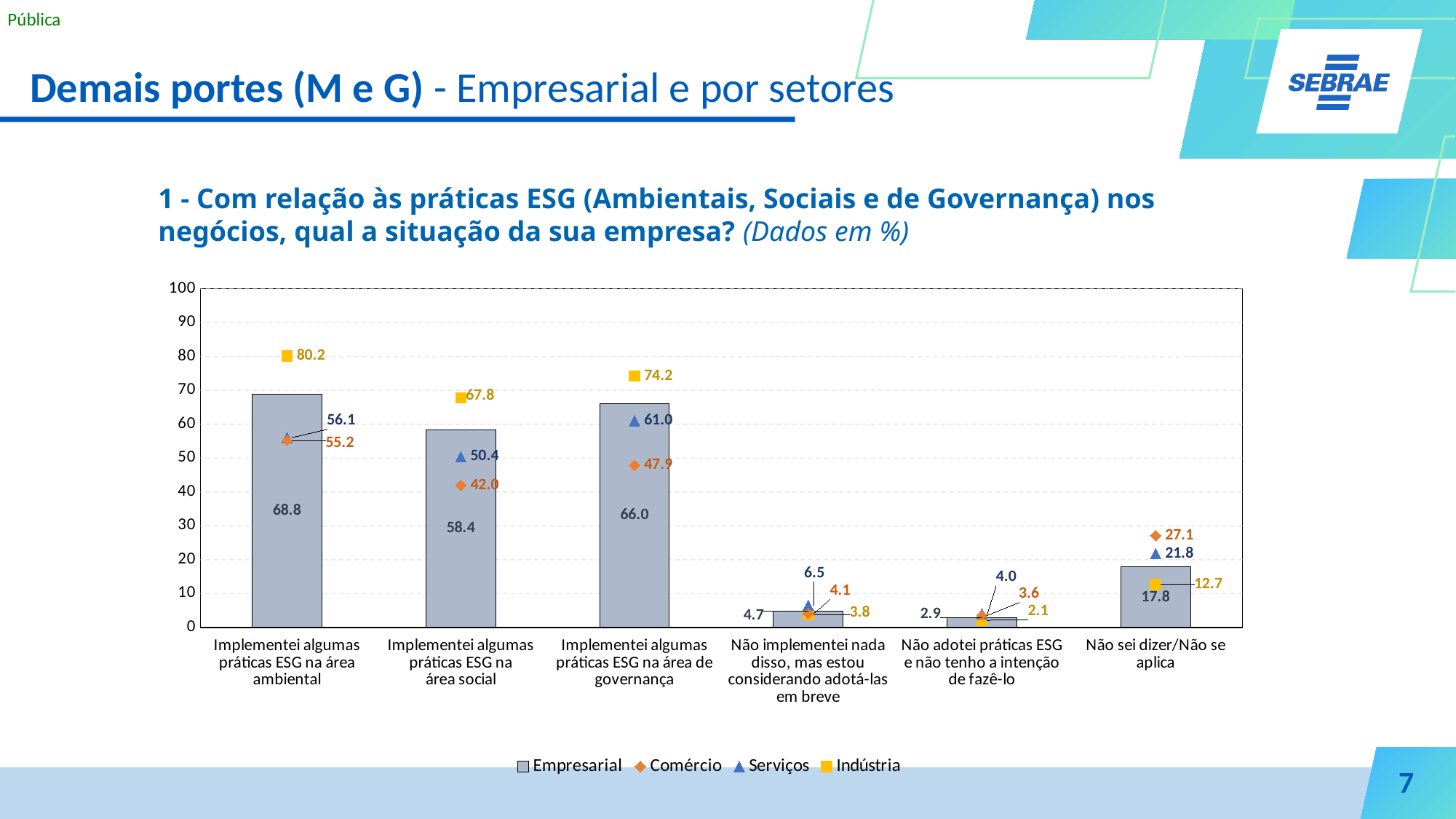
What kind of chart is used for the Empresarial series? Bar chart What is the Serviços value for "Implementei algumas práticas ESG na área social"? 50.4 What is the Indústria value for "Implementei algumas práticas ESG na área de governança"? 74.2 For "Não sei dizer/Não se aplica", which is larger: the Comércio value or the Serviços value? Comércio What is the difference between the Indústria and Empresarial values for "Implementei algumas práticas ESG na área ambiental"? 11.4 How many series does the legend list? 4 Which category has the lowest Empresarial value? Não adotei práticas ESG e não tenho a intenção de fazê-lo Which series is represented by the yellow square markers? Indústria What is the Comércio value for "Não sei dizer/Não se aplica"? 27.1 How many categories are shown on the x axis? 6 What is the Empresarial value for "Implementei algumas práticas ESG na área ambiental"? 68.8 Which category has the highest Indústria value? Implementei algumas práticas ESG na área ambiental